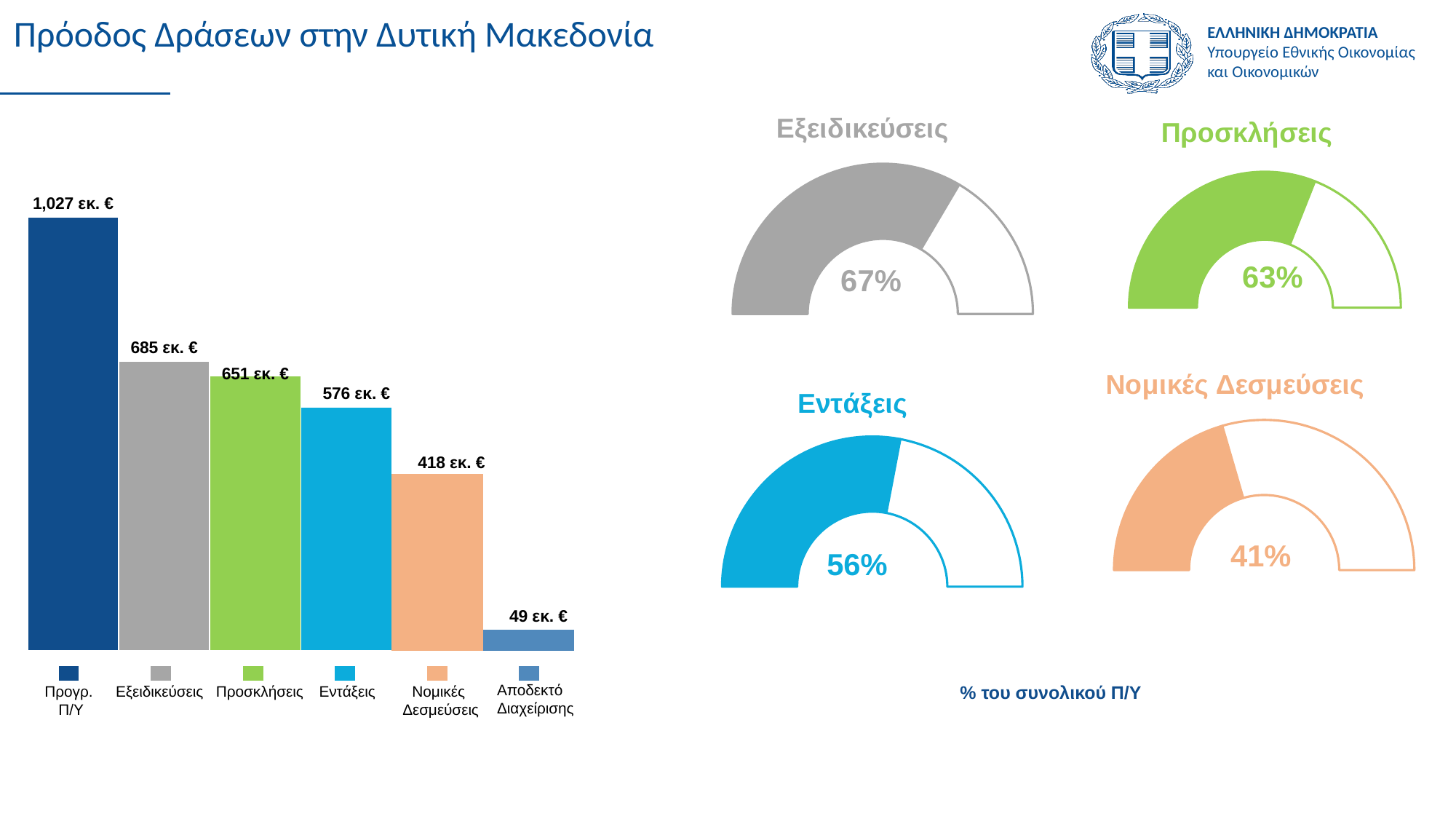
How many categories does the bar chart on the left show? 6 In the gauge chart titled Εξειδικεύσεις, what percentage is shown? 67% In the bar chart on the left, what is the difference between Εξειδικεύσεις and Προσκλήσεις? 34 εκ. € In the bar chart on the left, what is the value for Νομικές Δεσμεύσεις? 418 εκ. € In the bar chart on the left, which is larger: Προσκλήσεις or Εντάξεις? Προσκλήσεις In the bar chart on the left, which category has the lowest value? Αποδεκτό Διαχείρισης In the gauge chart titled Νομικές Δεσμεύσεις, what percentage is shown? 41% In the bar chart on the left, what is the value for Προγρ. Π/Υ? 1,027 εκ. € In the bar chart on the left, which category has the highest value? Προγρ. Π/Υ What kind of chart is shown on the left of the slide? Bar chart In the bar chart on the left, what is the difference between Εντάξεις and Νομικές Δεσμεύσεις? 158 εκ. € Among the four gauge charts on the right, which one shows the lowest percentage? Νομικές Δεσμεύσεις